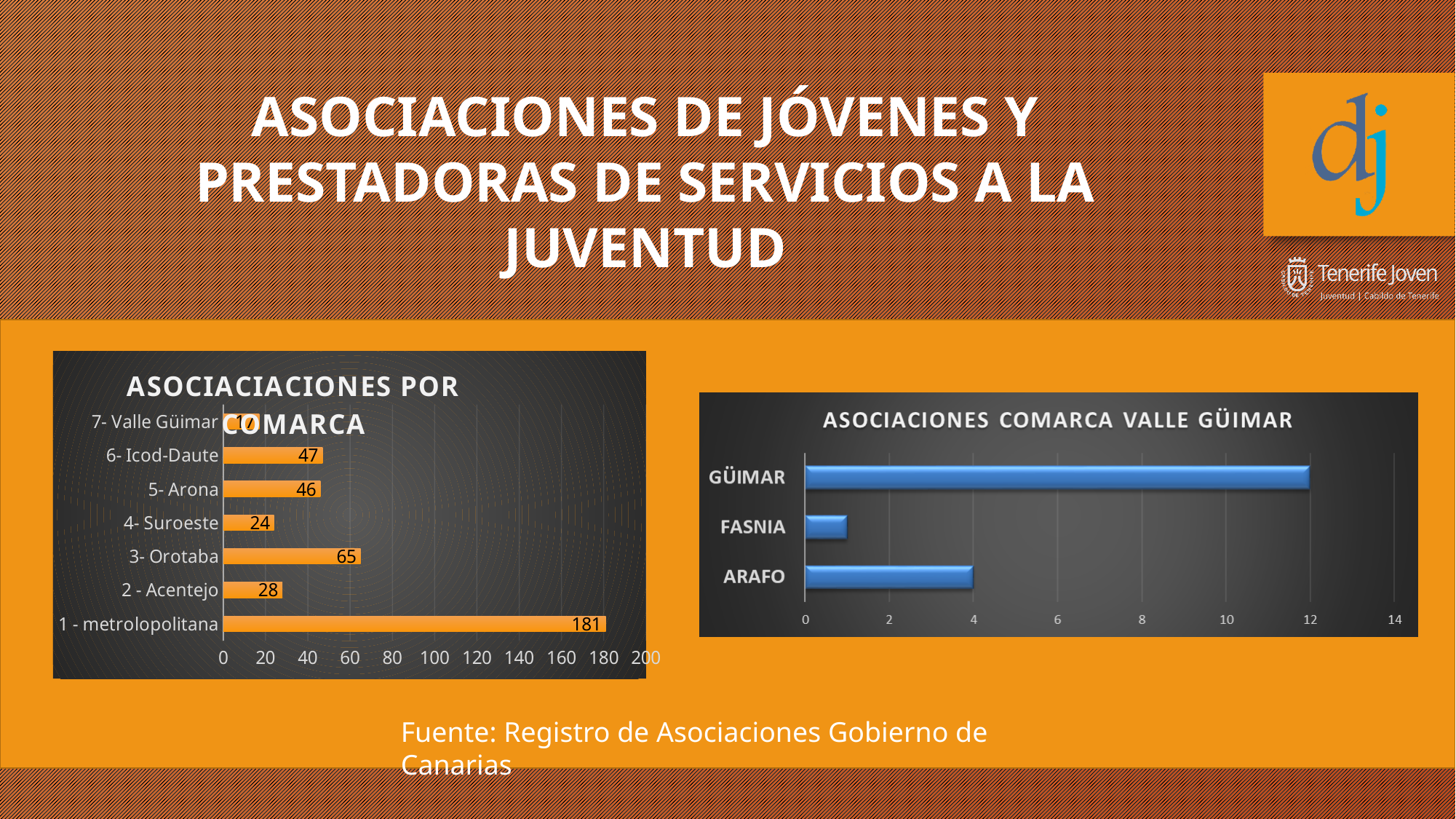
In the chart titled ASOCIACIACIONES POR COMARCA, what is the difference between 6- Icod-Daute and 2 - Acentejo? 19 In the chart titled ASOCIACIONES COMARCA VALLE GÜIMAR, is the value for ARAFO greater or less than 6? less In the chart titled ASOCIACIACIONES POR COMARCA, which is larger, 3- Orotaba or 5- Arona? 3- Orotaba In the chart titled ASOCIACIONES COMARCA VALLE GÜIMAR, which municipality has the lowest value? FASNIA What kind of chart is the one titled ASOCIACIONES COMARCA VALLE GÜIMAR? bar chart In the chart titled ASOCIACIACIONES POR COMARCA, which comarca has the highest value? 1 - metrolopolitana In the chart titled ASOCIACIACIONES POR COMARCA, what is the value for 1 - metrolopolitana? 181 In the chart titled ASOCIACIONES COMARCA VALLE GÜIMAR, is the value for GÜIMAR greater or less than 10? greater In the chart titled ASOCIACIACIONES POR COMARCA, what is the value for 4- Suroeste? 24 In the chart titled ASOCIACIONES COMARCA VALLE GÜIMAR, which municipality has the highest value? GÜIMAR In the chart titled ASOCIACIACIONES POR COMARCA, what is the value for 3- Orotaba? 65 In the chart titled ASOCIACIACIONES POR COMARCA, how many comarcas are shown? 7